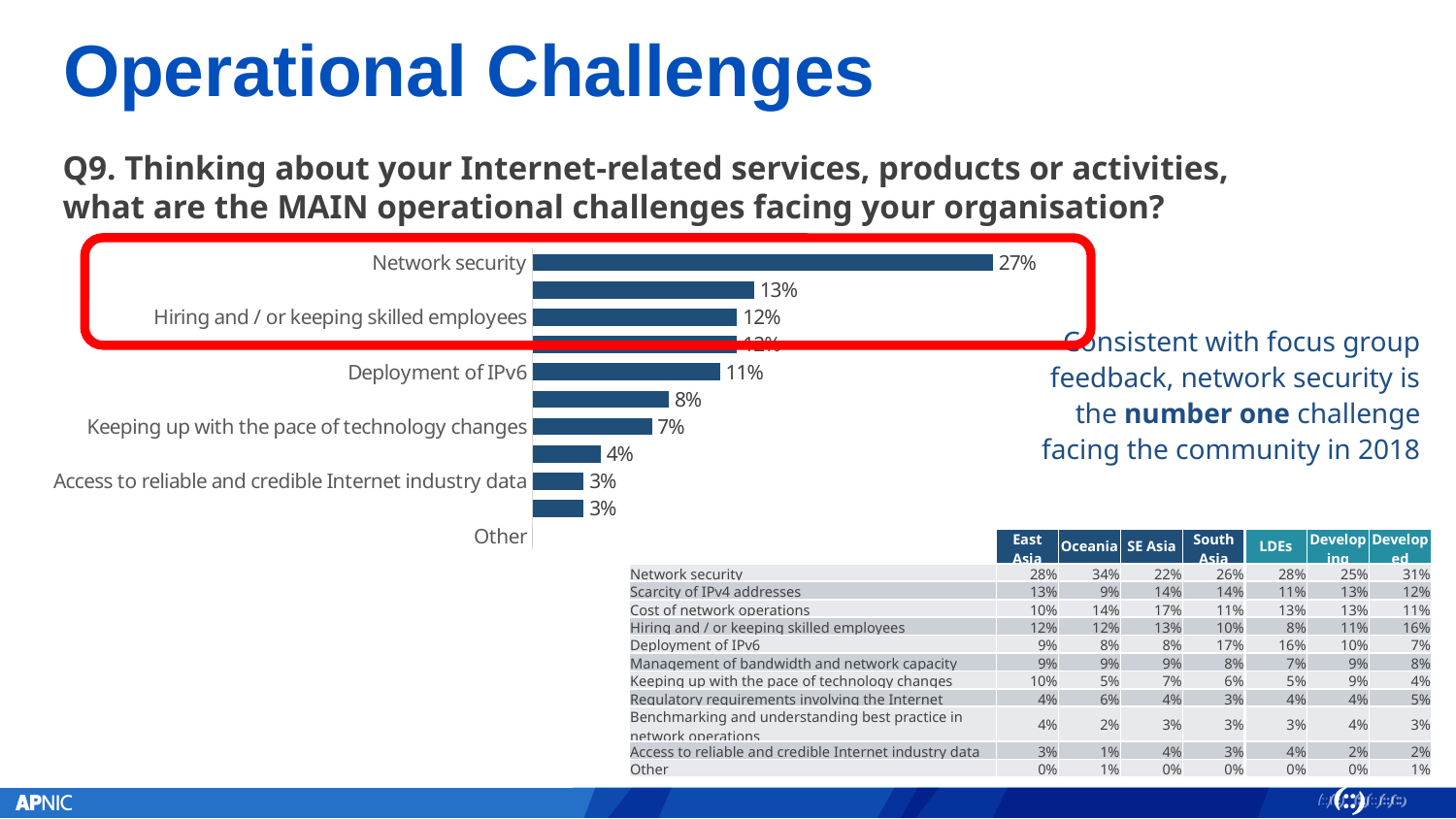
What is the value for Keeping up with the pace of technology changes in the bar chart? 7% In the bar chart, which is larger: Deployment of IPv6 or Keeping up with the pace of technology changes? Deployment of IPv6 What kind of chart is shown on the slide? Bar chart Which category has the highest value in the bar chart? Network security What is the value for Access to reliable and credible Internet industry data in the bar chart? 3% What is the value for Network security in the bar chart? 27% What is the difference between the values for Network security and Hiring and / or keeping skilled employees in the bar chart? 15 percentage points What is the difference between the values for Deployment of IPv6 and Access to reliable and credible Internet industry data in the bar chart? 8 percentage points What is the value for Hiring and / or keeping skilled employees in the bar chart? 12% What colour are the bars in the chart? Dark blue In the bar chart, which is larger: Hiring and / or keeping skilled employees or Access to reliable and credible Internet industry data? Hiring and / or keeping skilled employees What is the value for Deployment of IPv6 in the bar chart? 11%